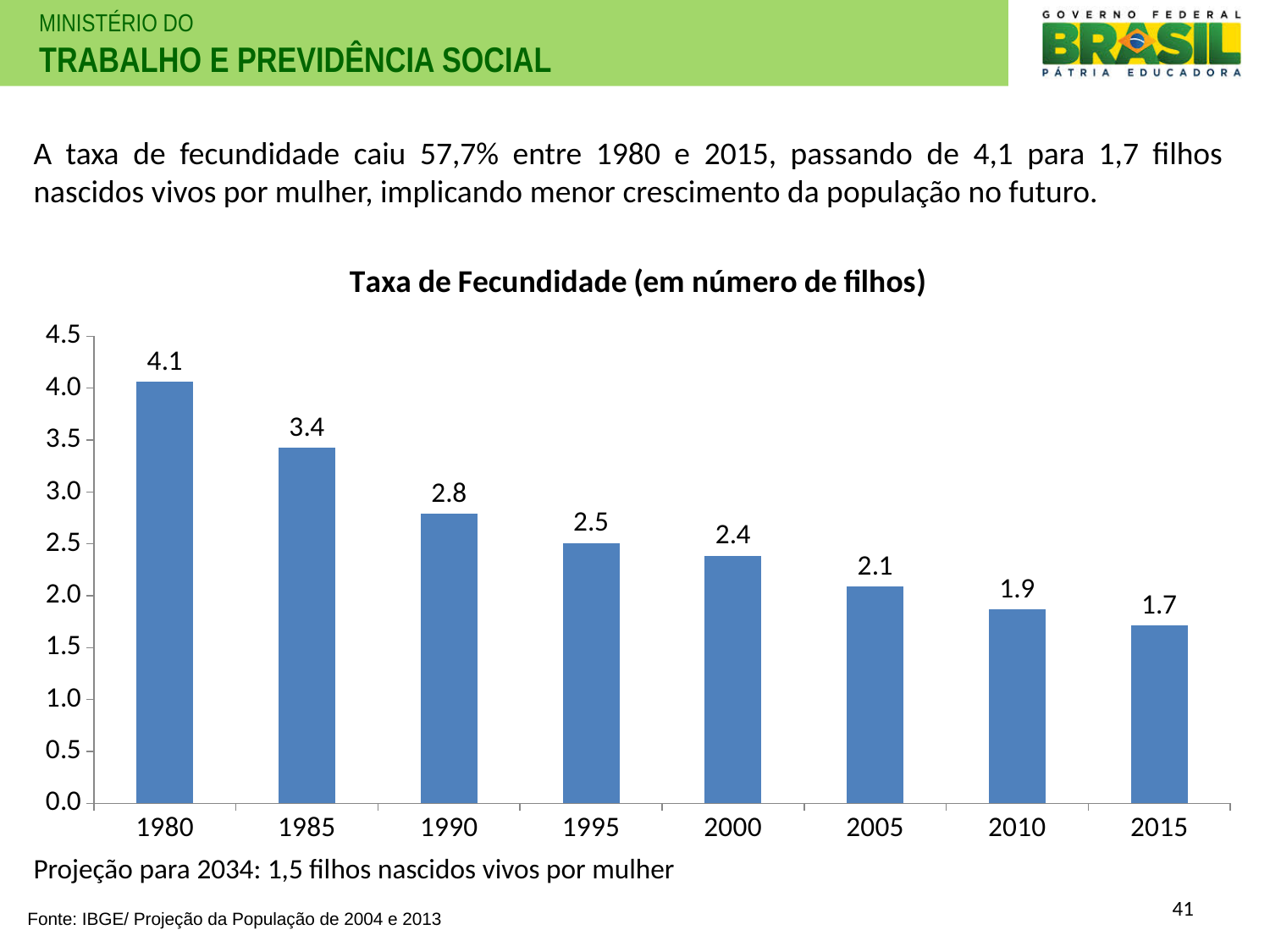
Do the values rise or fall from 1980 to 2015? fall What kind of chart is shown on the slide? bar chart Is the value for 2010 greater or less than 2.0? less What is the difference between the fertility rate in 1980 and in 2015? 2.4 Which year has the highest fertility rate? 1980 Which is larger, the fertility rate in 1995 or in 2005? 1995 What is the fertility rate shown for 2015? 1.7 What is the fertility rate shown for 1980? 4.1 What is the difference between the fertility rate in 1985 and in 1990? 0.6 Which year has the lowest fertility rate? 2015 What is the fertility rate shown for 2000? 2.4 How many years are shown on the x axis of the chart? 8